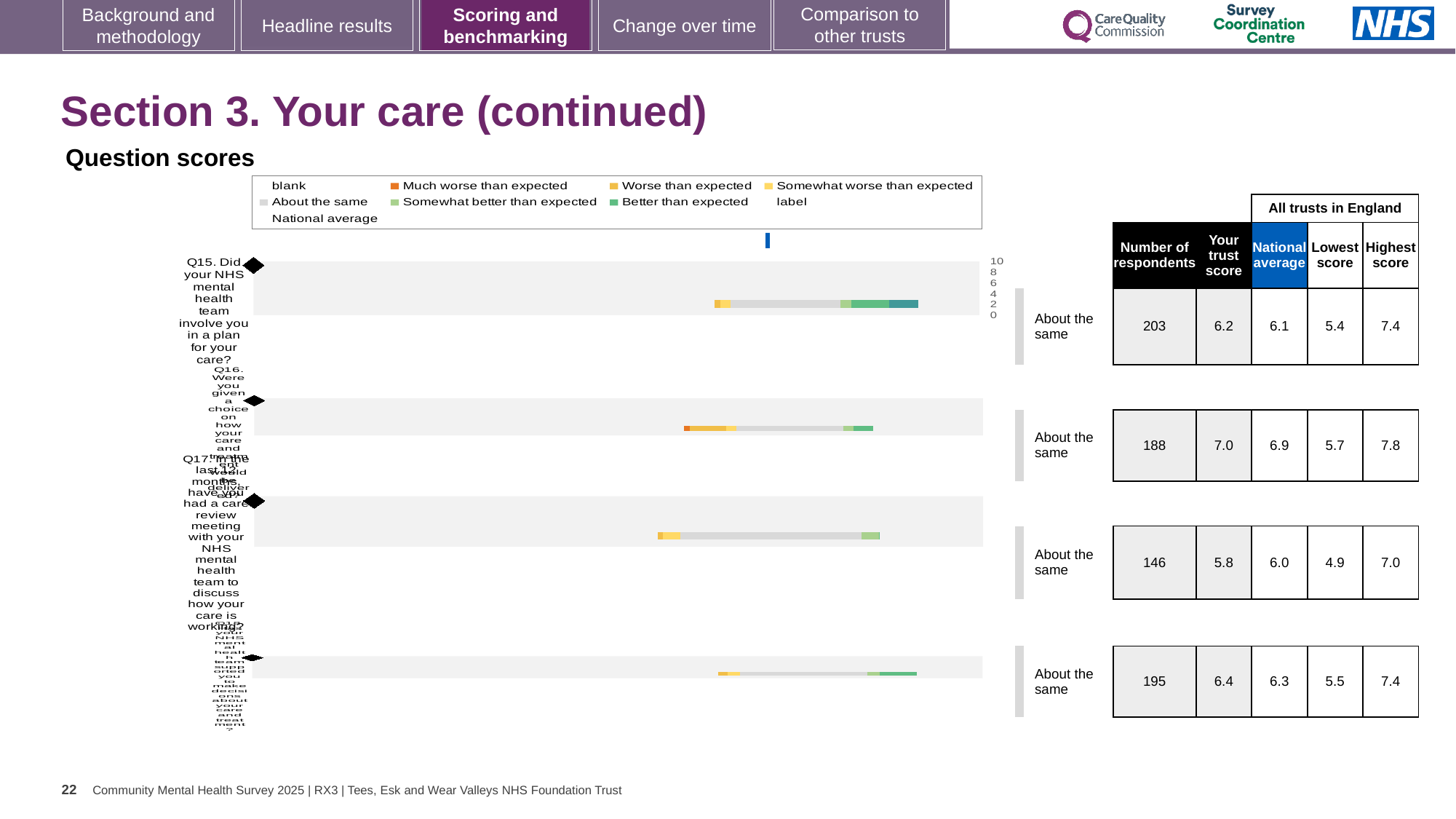
What is the national average score for Q16 (Were you given a choice on how your care and treatment would be delivered)? 6.9 For Q17, which is larger: the trust score or the national average? National average What benchmark category is shown for Q15 next to the chart? About the same How many respondents answered Q17 (In the last 12 months, have you had a care review meeting)? 146 What kind of chart is used to show the question scores on this slide? bar chart For Q15, what is the difference between the highest score and the lowest score across all trusts in England? 2.0 What is the 'Your trust score' value for Q15 (Did your NHS mental health team involve you in a plan for your care?)? 6.2 How many respondents are recorded for the bottom (fourth) question row in the table? 195 How many questions (bars) are plotted in the question scores chart? 4 What is the highest score across all trusts in England for Q16? 7.8 Which question has the lowest 'Your trust score'? Q17 Which question has the highest 'Your trust score'? Q16